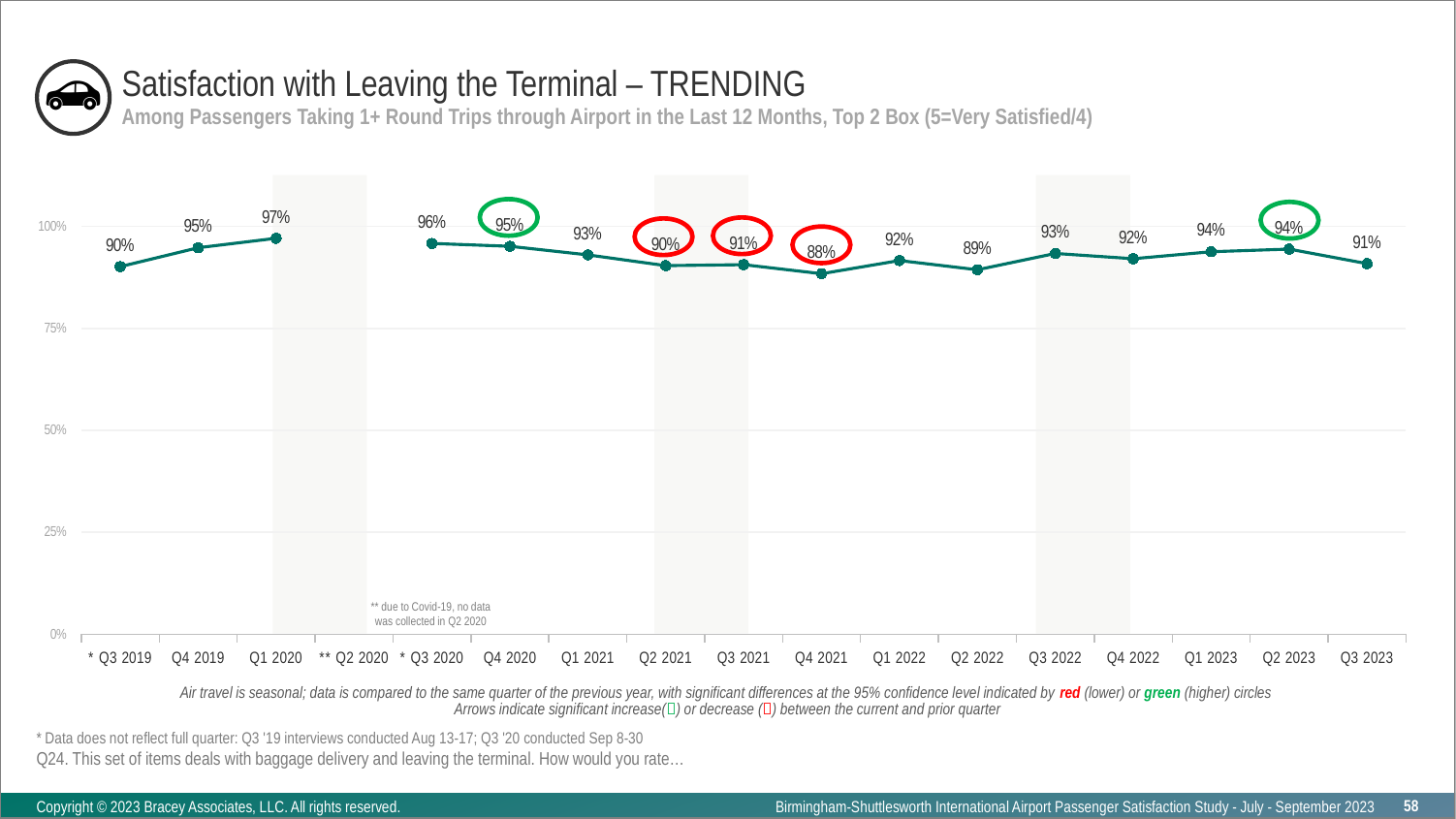
Which quarter has the lowest satisfaction value? Q4 2021 What is the difference between the values for Q1 2020 and Q4 2021? 9 percentage points What is the satisfaction value for Q3 2023? 91% How many quarters are labeled on the x axis? 17 What type of chart is shown on the slide? Line chart Which quarter has the highest satisfaction value? Q1 2020 What is the satisfaction value for Q4 2021? 88% What is the satisfaction value for Q1 2020? 97% Is the value for Q2 2022 greater or less than 75%? greater What is the title of the chart? Satisfaction with Leaving the Terminal – TRENDING Which quarter has no data plotted due to Covid-19? Q2 2020 Which is larger, the value for Q3 2022 or the value for Q2 2022? Q3 2022